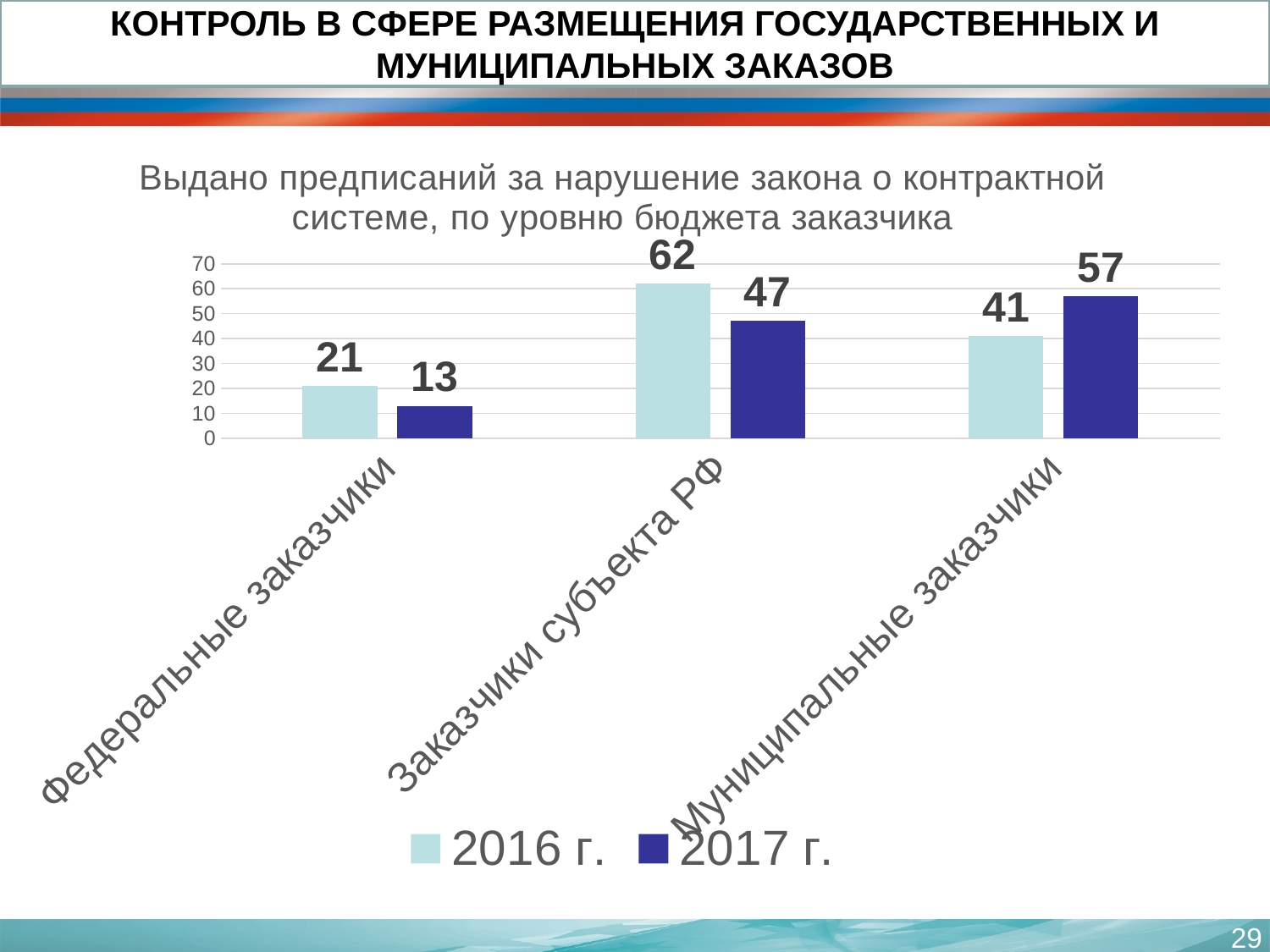
Which category has the highest value in 2016 г.? Заказчики субъекта РФ What is the value for Заказчики субъекта РФ in 2017 г.? 47 Which category has the lowest value in 2017 г.? Федеральные заказчики What kind of chart is shown on the slide? bar chart Is the value for Муниципальные заказчики in 2016 г. greater or less than 50? less How many categories are shown on the x axis? 3 What is the difference between the 2016 г. and 2017 г. values for Заказчики субъекта РФ? 15 How many series does the legend list? 2 Which is larger for Муниципальные заказчики: the 2016 г. value or the 2017 г. value? 2017 г. What is the value for Муниципальные заказчики in 2017 г.? 57 What is the title of the chart? Выдано предписаний за нарушение закона о контрактной системе, по уровню бюджета заказчика What is the value for Федеральные заказчики in 2016 г.? 21